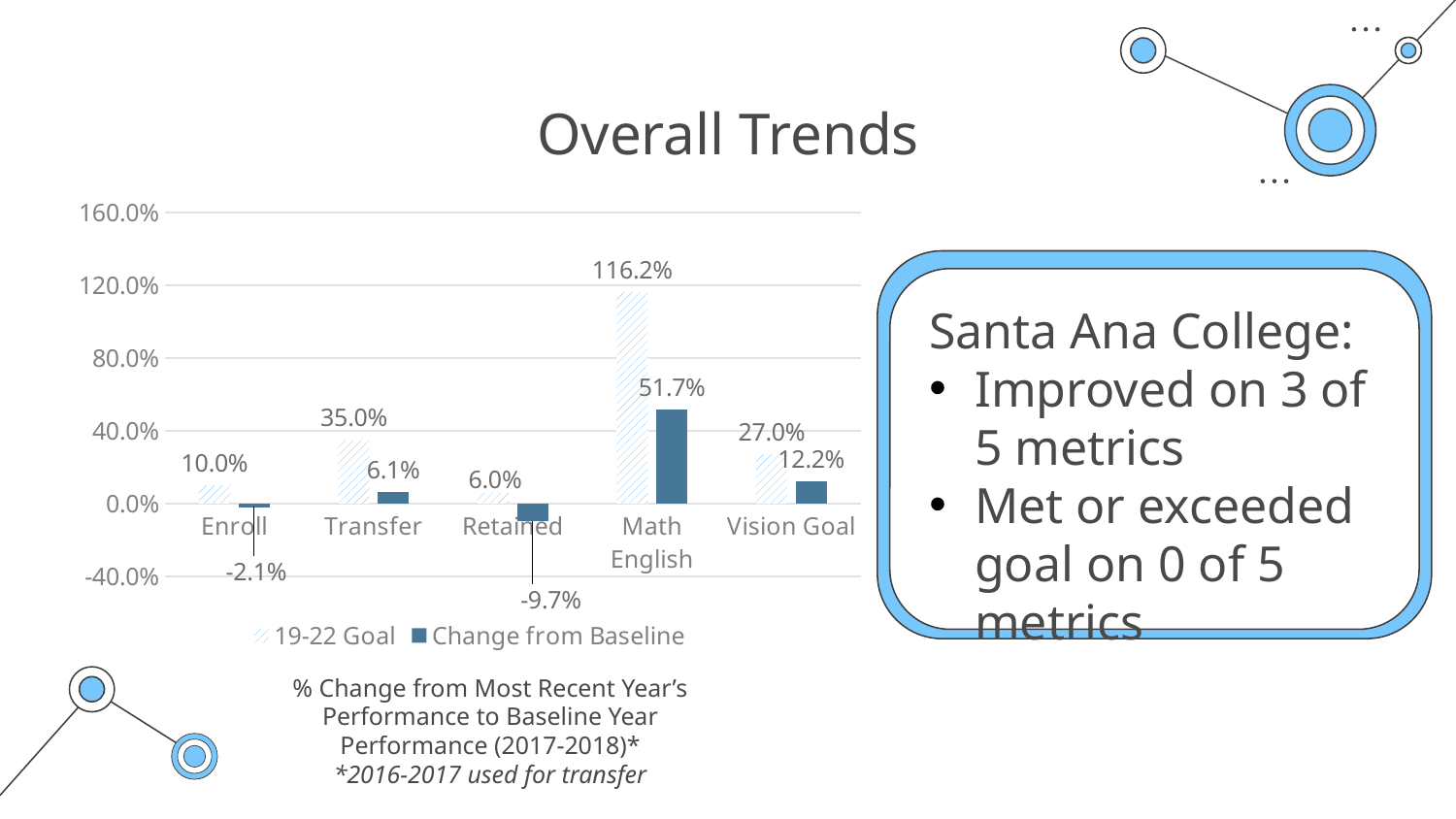
Which category has the highest Change from Baseline value? Math English What is the Change from Baseline value for Retained? -9.7% What is the difference between the 19-22 Goal and the Change from Baseline for Math English? 64.5% What is the 19-22 Goal value for Math English? 116.2% What is the 19-22 Goal value for Vision Goal? 27.0% Which is larger for Enroll: the 19-22 Goal or the Change from Baseline? 19-22 Goal What kind of chart is shown on the slide? Bar chart Which category has the lowest 19-22 Goal value? Retained What is the Change from Baseline value for Transfer? 6.1% How many series does the legend list? 2 Which category has the lowest Change from Baseline value? Retained How many categories are shown on the x axis? 5